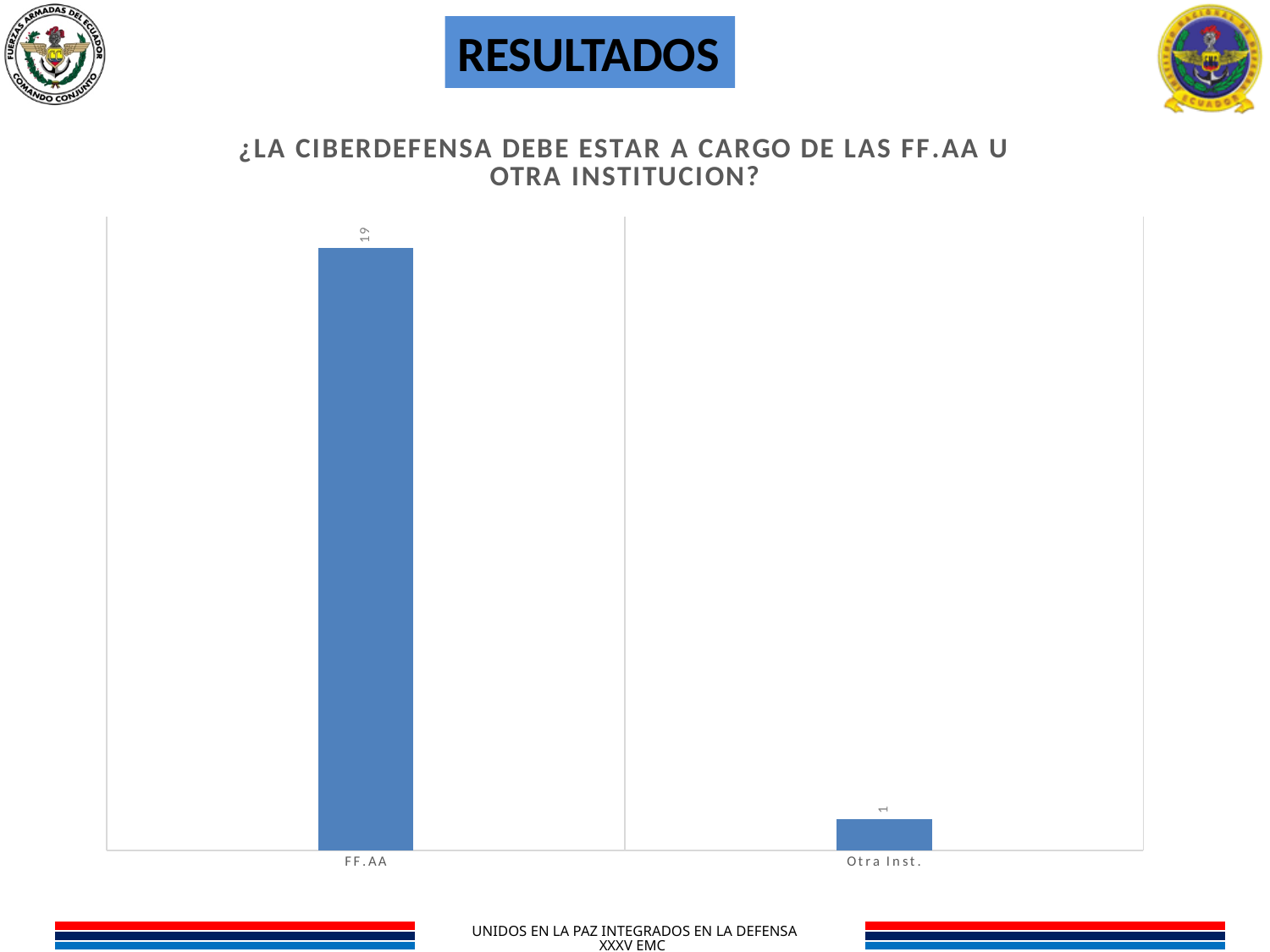
What is the title of the chart? ¿LA CIBERDEFENSA DEBE ESTAR A CARGO DE LAS FF.AA U OTRA INSTITUCION? What is the total of the two values shown in the chart? 20 What is the value for Otra Inst.? 1 Which category has the highest value? FF.AA Do the values rise or fall from left to right along the x axis? Fall What kind of chart is shown on the slide? Bar chart How many categories are shown on the x axis? 2 Which category has the lowest value? Otra Inst. What is the difference between the values for FF.AA and Otra Inst.? 18 What colour are the bars in the chart? Blue What is the value for FF.AA? 19 Which is larger, the value for FF.AA or the value for Otra Inst.? FF.AA